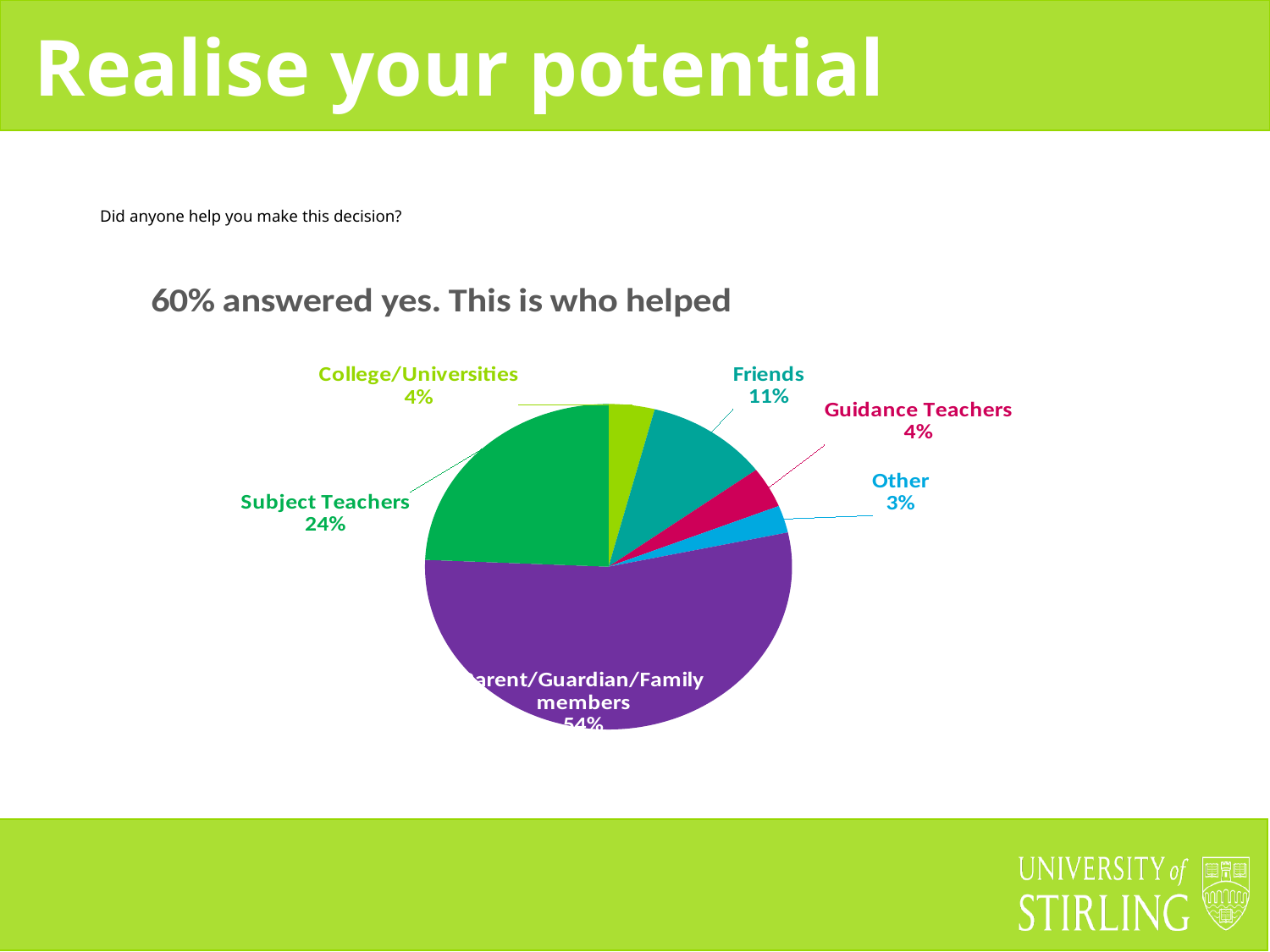
What percentage of the pie is Friends? 11% What percentage of the pie is Subject Teachers? 24% What kind of chart is shown on the slide? pie chart How many slices does the pie chart have? 6 Which slice of the pie is the smallest? Other Which is larger, the Subject Teachers slice or the Friends slice? Subject Teachers What percentage of the pie is Other? 3% What percentage of the pie is College/Universities? 4% What is the chart's title? 60% answered yes. This is who helped Which slice of the pie is the largest? Parent/Guardian/Family members What is the difference in percentage points between Subject Teachers and Friends? 13 What percentage of the pie is Guidance Teachers? 4%